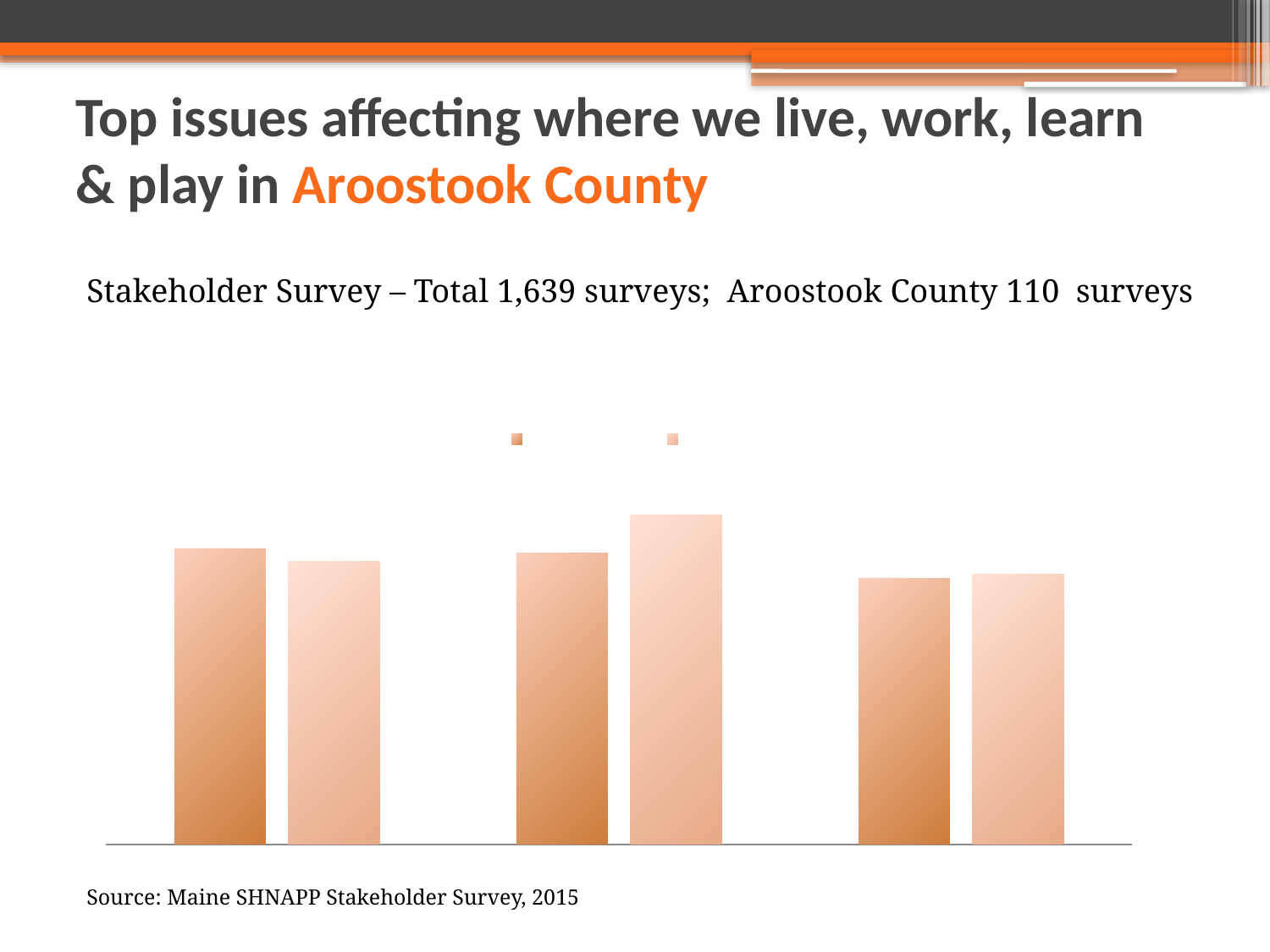
Does the chart display numeric data labels on its bars? No What kind of chart is shown on the slide? bar chart In the left group of bars, is the darker bar or the lighter bar taller? the darker bar In the middle group of bars, is the darker bar or the lighter bar taller? the lighter bar How many bars are plotted in the chart in total? 6 Which group of bars, left, middle or right, contains the shortest bar in the chart? right How many groups of bars are plotted in the chart? 3 How many series does the chart's legend list? 2 Which group of bars, left, middle or right, contains the tallest bar in the chart? middle What colour are the bars in the chart? orange